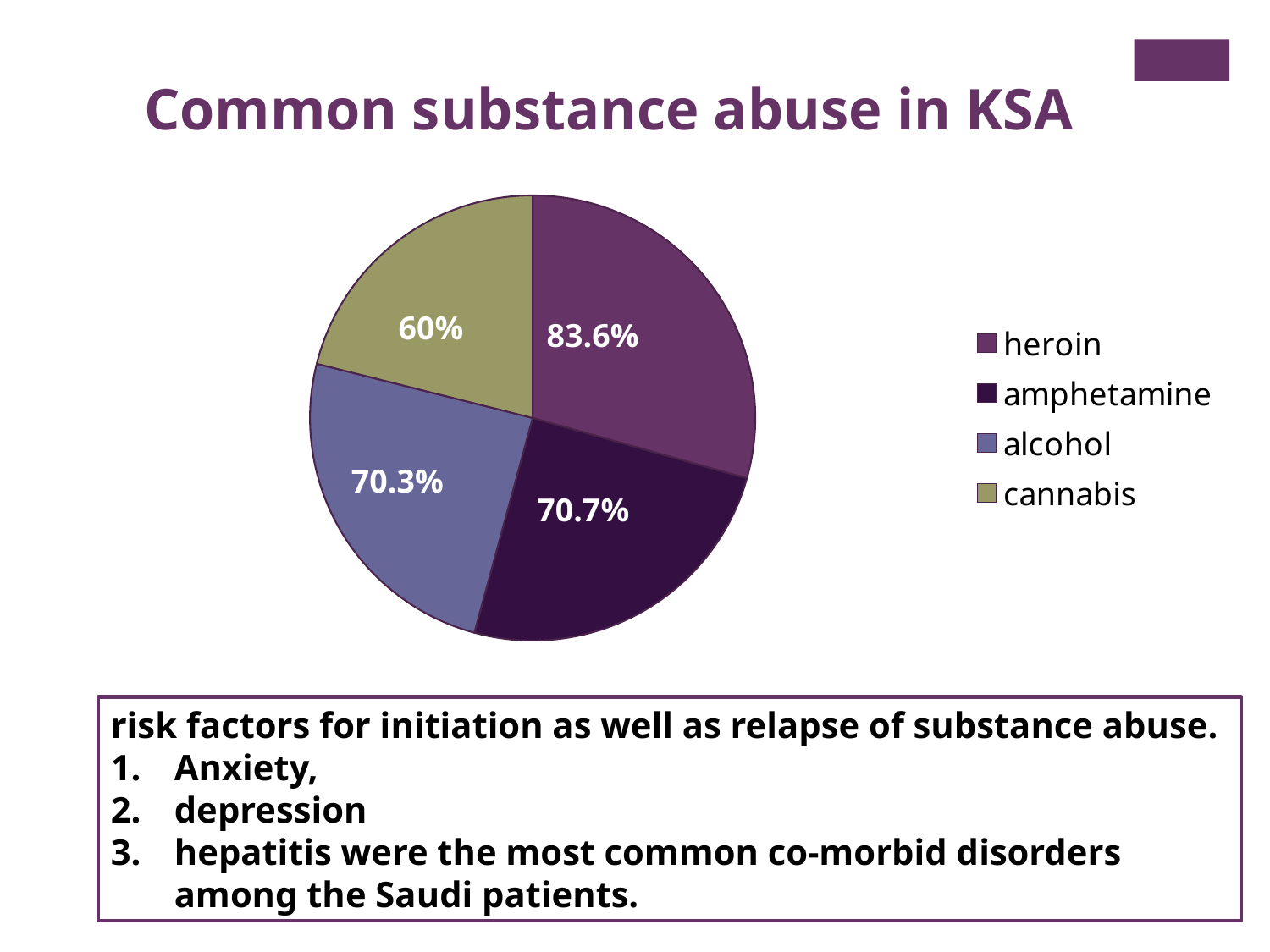
What is the difference between the values for heroin and amphetamine? 12.9% What is the difference between the values for heroin and cannabis? 23.6% What is the value shown for heroin? 83.6% Which substance has the lowest value in the pie chart? cannabis What is the value shown for alcohol? 70.3% Which has a larger value, heroin or alcohol? heroin Which substance has the highest value in the pie chart? heroin What type of chart is shown on the slide? pie chart What is the value shown for amphetamine? 70.7% How many slices does the pie chart have? 4 What is the value shown for cannabis? 60% What is the title of the chart on the slide? Common substance abuse in KSA